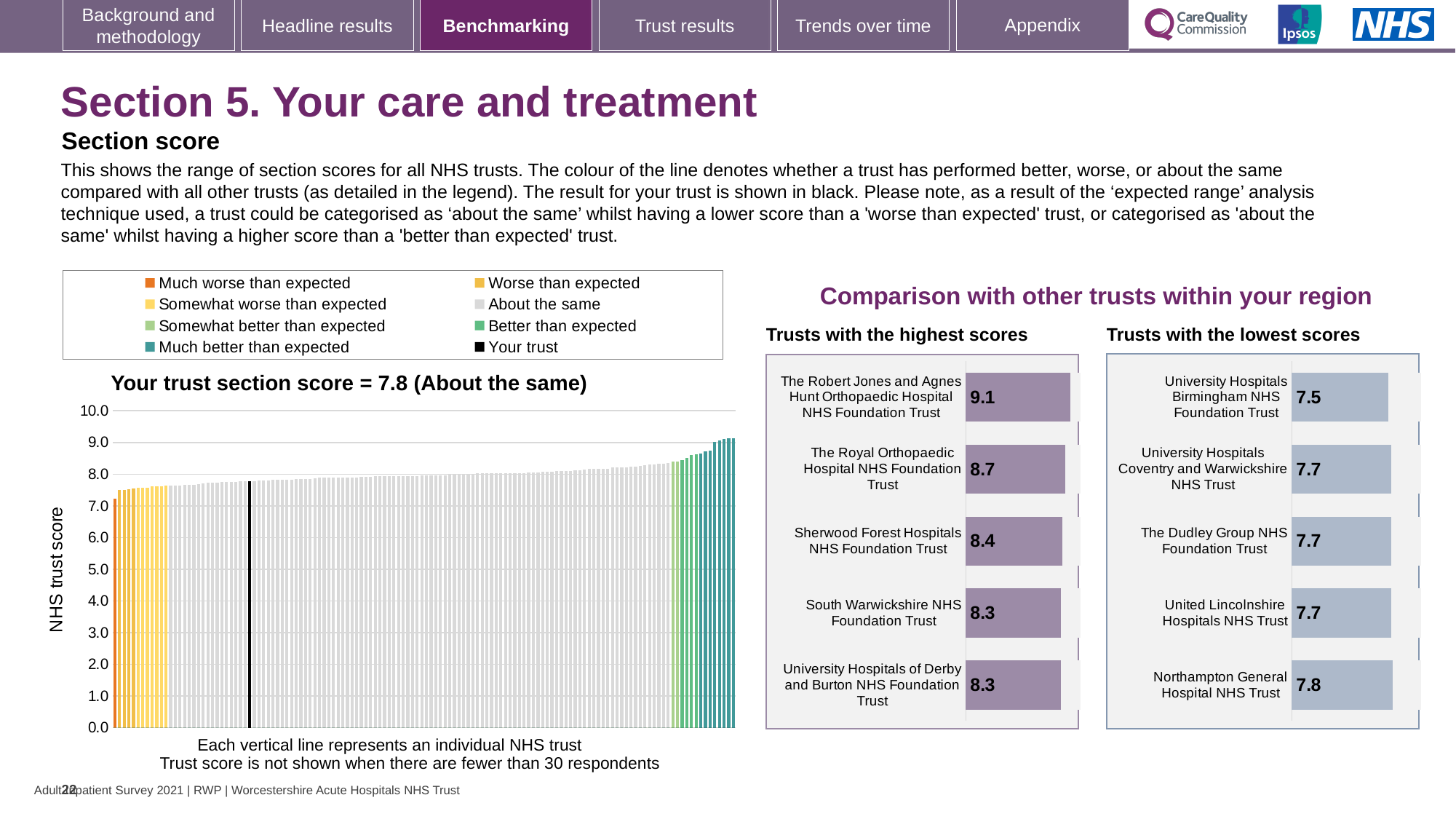
What kind of chart is the main chart on the left showing the range of section scores for all NHS trusts? Bar chart In the 'Trusts with the highest scores' chart, what is the difference between the scores of The Robert Jones and Agnes Hunt Orthopaedic Hospital NHS Foundation Trust and The Royal Orthopaedic Hospital NHS Foundation Trust? 0.4 How many trusts are shown in the 'Trusts with the lowest scores' chart? 5 In the 'Trusts with the lowest scores' chart, which trust has the lowest score? University Hospitals Birmingham NHS Foundation Trust In the 'Trusts with the lowest scores' chart, what is the difference between the scores of Northampton General Hospital NHS Trust and University Hospitals Birmingham NHS Foundation Trust? 0.3 In the 'Trusts with the highest scores' chart, which has the higher score: The Royal Orthopaedic Hospital NHS Foundation Trust or South Warwickshire NHS Foundation Trust? The Royal Orthopaedic Hospital NHS Foundation Trust In the 'Trusts with the lowest scores' chart, what is the score for Northampton General Hospital NHS Trust? 7.8 In the 'Trusts with the highest scores' chart, which trust has the highest score? The Robert Jones and Agnes Hunt Orthopaedic Hospital NHS Foundation Trust In the main chart on the left, what is the section score for your trust as stated in the chart title? 7.8 In the 'Trusts with the lowest scores' chart, what is the score for University Hospitals Birmingham NHS Foundation Trust? 7.5 In the 'Trusts with the highest scores' chart, what is the score for The Robert Jones and Agnes Hunt Orthopaedic Hospital NHS Foundation Trust? 9.1 In the 'Trusts with the highest scores' chart, what is the score for Sherwood Forest Hospitals NHS Foundation Trust? 8.4